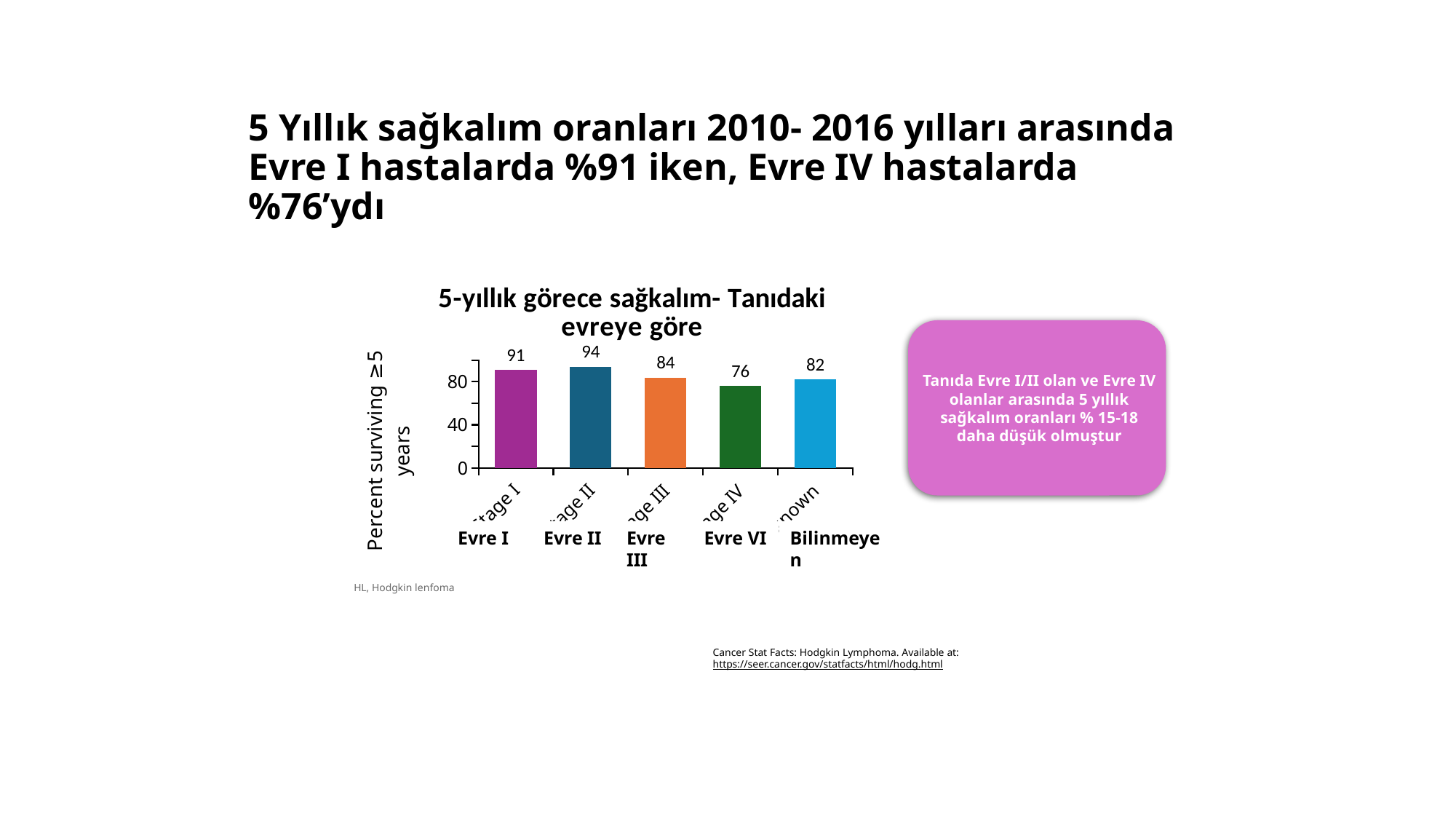
What is the title of the chart? 5-yıllık görece sağkalım- Tanıdaki evreye göre What is the value for Evre II (Stage II)? 94 How many categories are shown in the chart? 5 Which category has the highest value? Evre II What is the difference between the values for Evre I and Evre III? 7 What is the value for Evre III (Stage III)? 84 What is the difference between the values for Evre II and Evre VI? 18 What kind of chart is shown on the slide? bar chart What is the value for the Bilinmeyen (Unknown) category? 82 Which is larger, the value for Evre III or the value for Bilinmeyen? Evre III What is the value for Evre I (Stage I)? 91 Which category has the lowest value? Evre VI